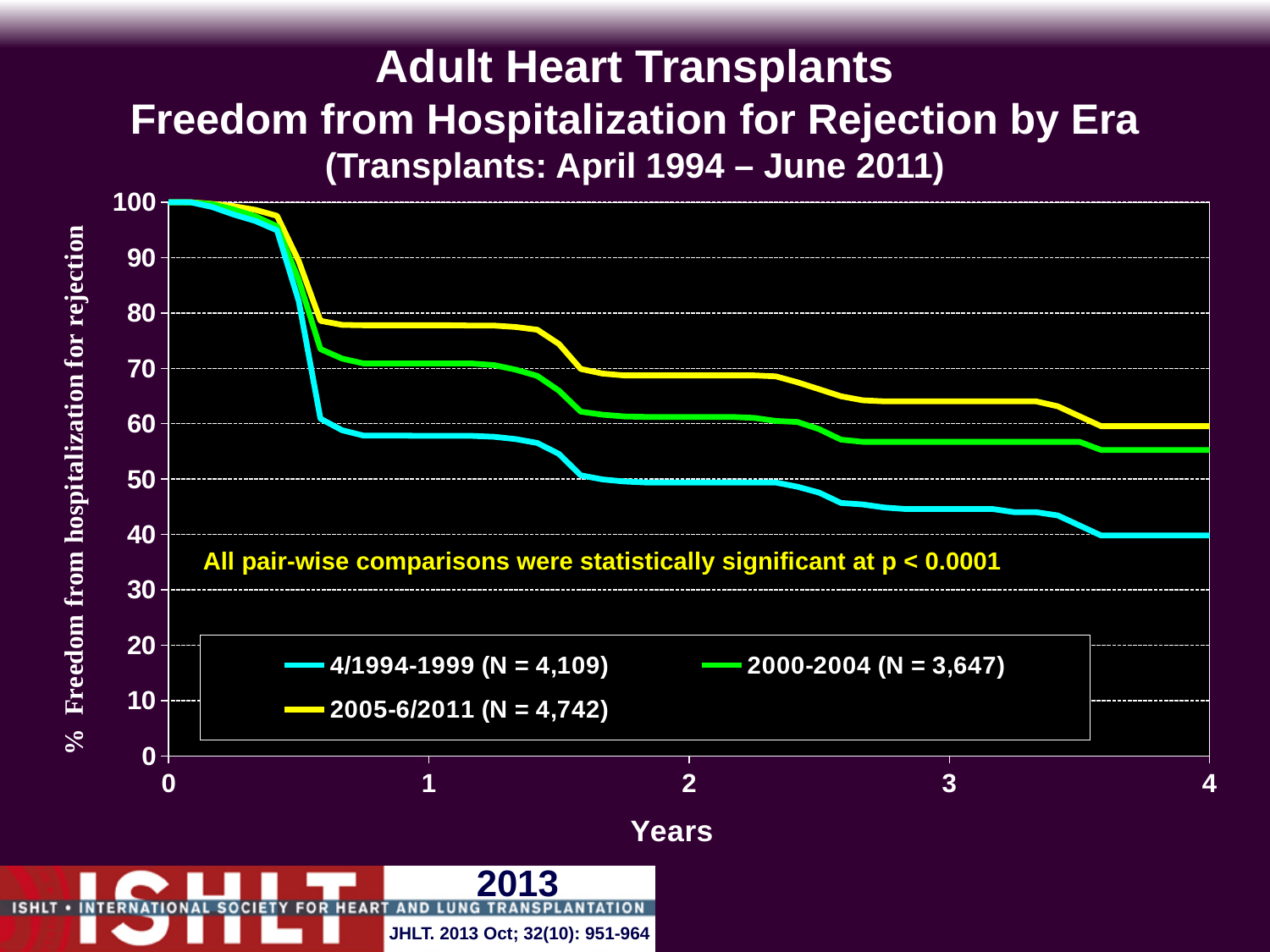
Is the value for the 2005-6/2011 era at 1 year greater or less than 70? greater What kind of chart is shown on the slide? line chart Which era has the highest freedom from hospitalization for rejection across the years shown? 2005-6/2011 How many series does the legend list? 3 Do the values for the 4/1994-1999 era rise or fall as years increase? fall At 2 years, which era has the larger value: 2005-6/2011 or 4/1994-1999? 2005-6/2011 What is the label of the x axis? Years Is the value for the 4/1994-1999 era at 4 years greater or less than 50? less What is the N for the 2000-2004 era shown in the legend? 3,647 Is the value for the 2000-2004 era at 4 years greater or less than 50? greater Which era has the lowest freedom from hospitalization for rejection across the years shown? 4/1994-1999